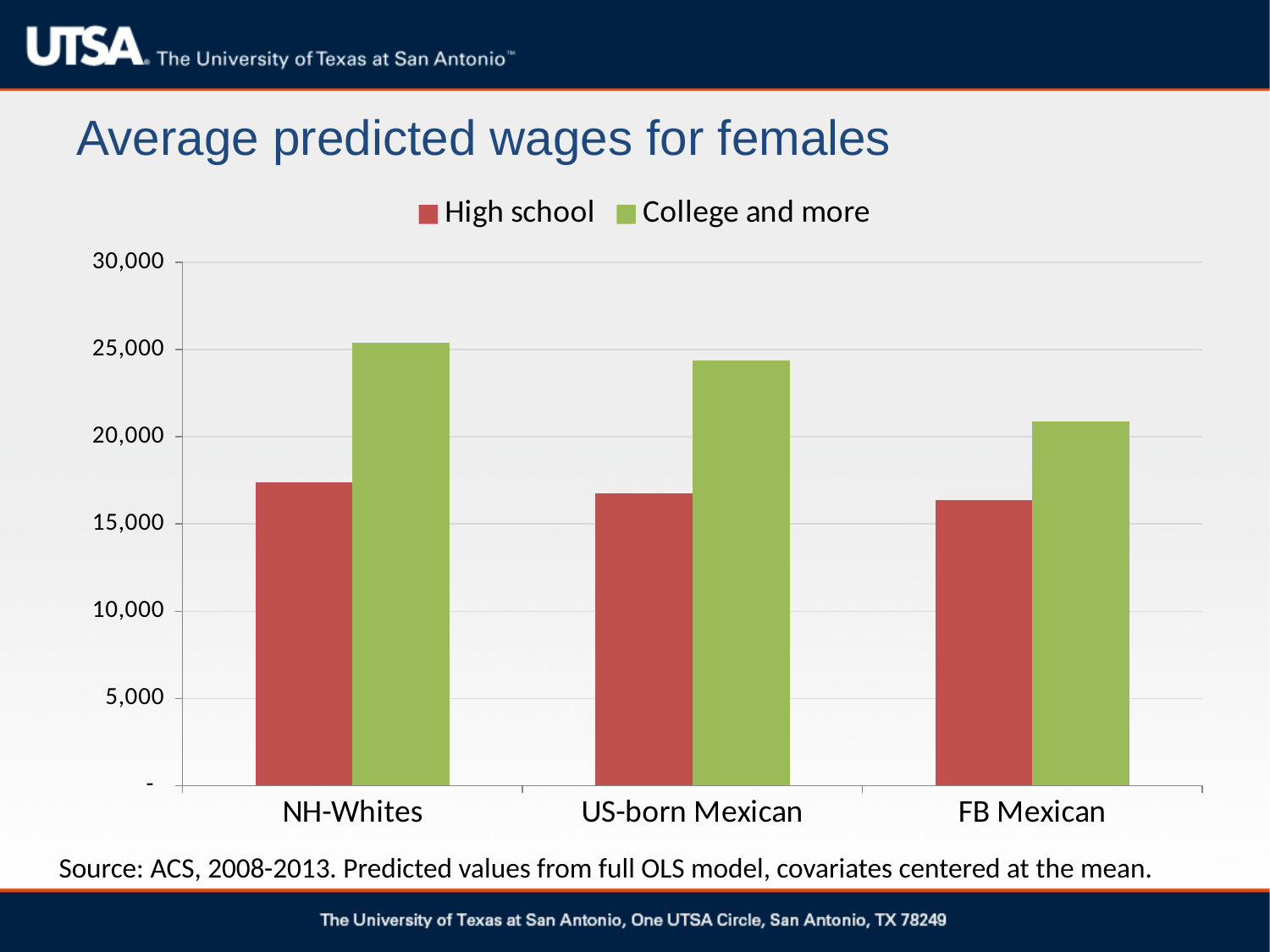
Which category has the highest High school value? NH-Whites Is the College and more value for US-born Mexican greater or less than 25,000? less Which category has the lowest College and more value? FB Mexican How many categories are shown on the x axis? 3 What is the title of the chart? Average predicted wages for females What kind of chart is shown on the slide? Bar chart Do the College and more values rise or fall from NH-Whites to FB Mexican along the x axis? fall Is the High school value for NH-Whites greater or less than 20,000? less For FB Mexican, which is larger: High school or College and more? College and more Which category has the highest College and more value? NH-Whites Is the College and more value for FB Mexican greater or less than 20,000? greater How many series does the legend list? 2